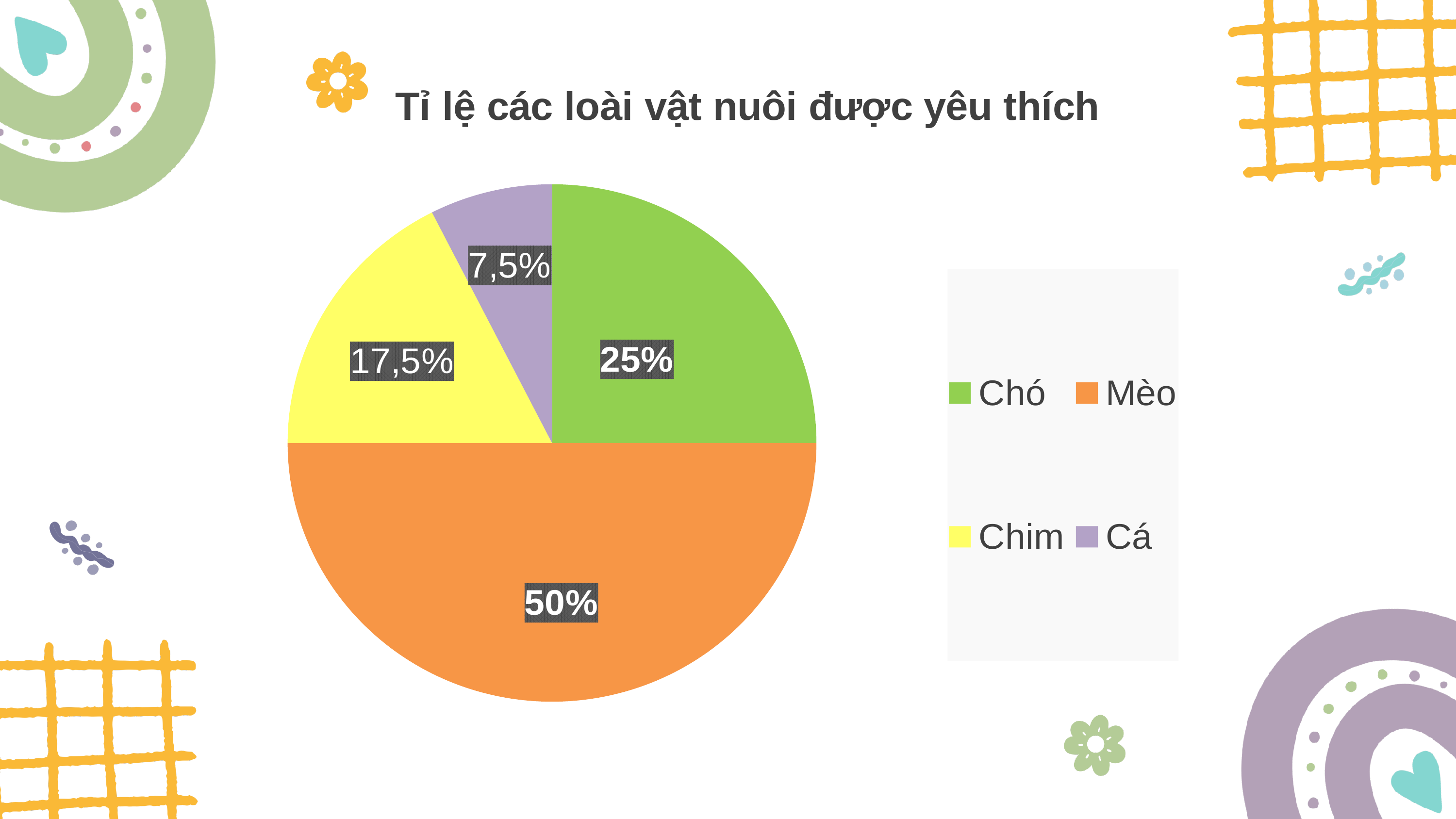
Which category has the smallest slice of the pie? Cá What is the title of the chart? Tỉ lệ các loài vật nuôi được yêu thích What is the difference between the shares of Chim and Cá? 10% What share of the pie does Chó have? 25% What share of the pie does Chim have? 17,5% How many categories does the pie chart show? 4 What share of the pie does Cá have? 7,5% Which is larger, the share for Chó or the share for Chim? Chó What kind of chart is shown on the slide? pie chart What is the difference between the shares of Mèo and Chó? 25% Which category has the largest slice of the pie? Mèo